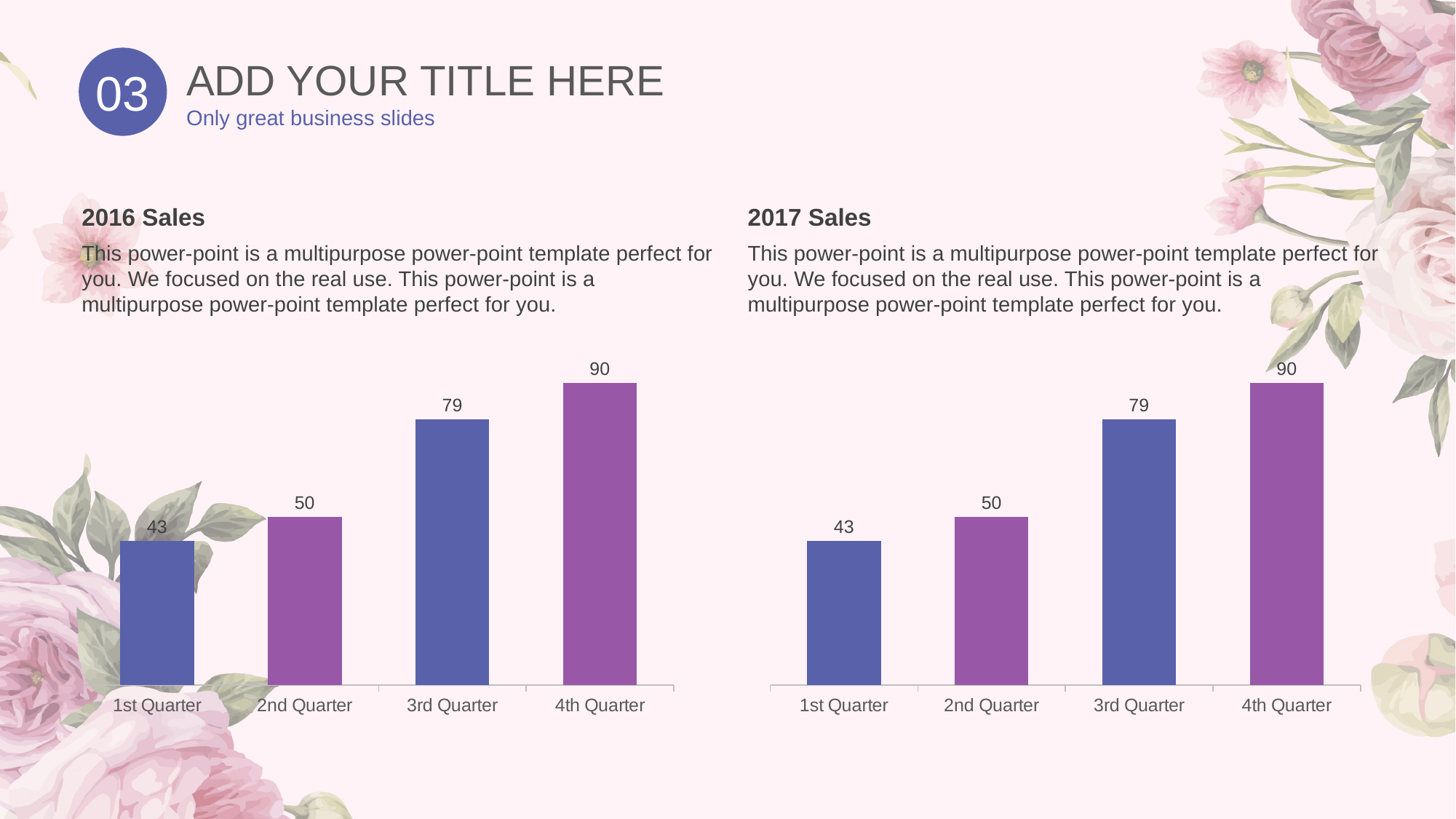
In the 2016 Sales chart, which is larger, the value for 2nd Quarter or 3rd Quarter? 3rd Quarter In the 2017 Sales chart, which quarter has the lowest value? 1st Quarter In the 2017 Sales chart, what is the value for 3rd Quarter? 79 In the 2017 Sales chart, do the values rise or fall from 1st Quarter to 4th Quarter? Rise What kind of chart is the 2016 Sales chart? Bar chart In the 2016 Sales chart, what is the value for 1st Quarter? 43 In the 2016 Sales chart, which quarter has the highest value? 4th Quarter In the 2016 Sales chart, what is the difference between the 4th Quarter and 2nd Quarter values? 40 In the 2016 Sales chart, what is the value for 2nd Quarter? 50 What is the title of the chart on the right side of the slide? 2017 Sales In the 2017 Sales chart, what is the difference between the 3rd Quarter and 1st Quarter values? 36 How many categories are shown in the 2017 Sales chart? 4